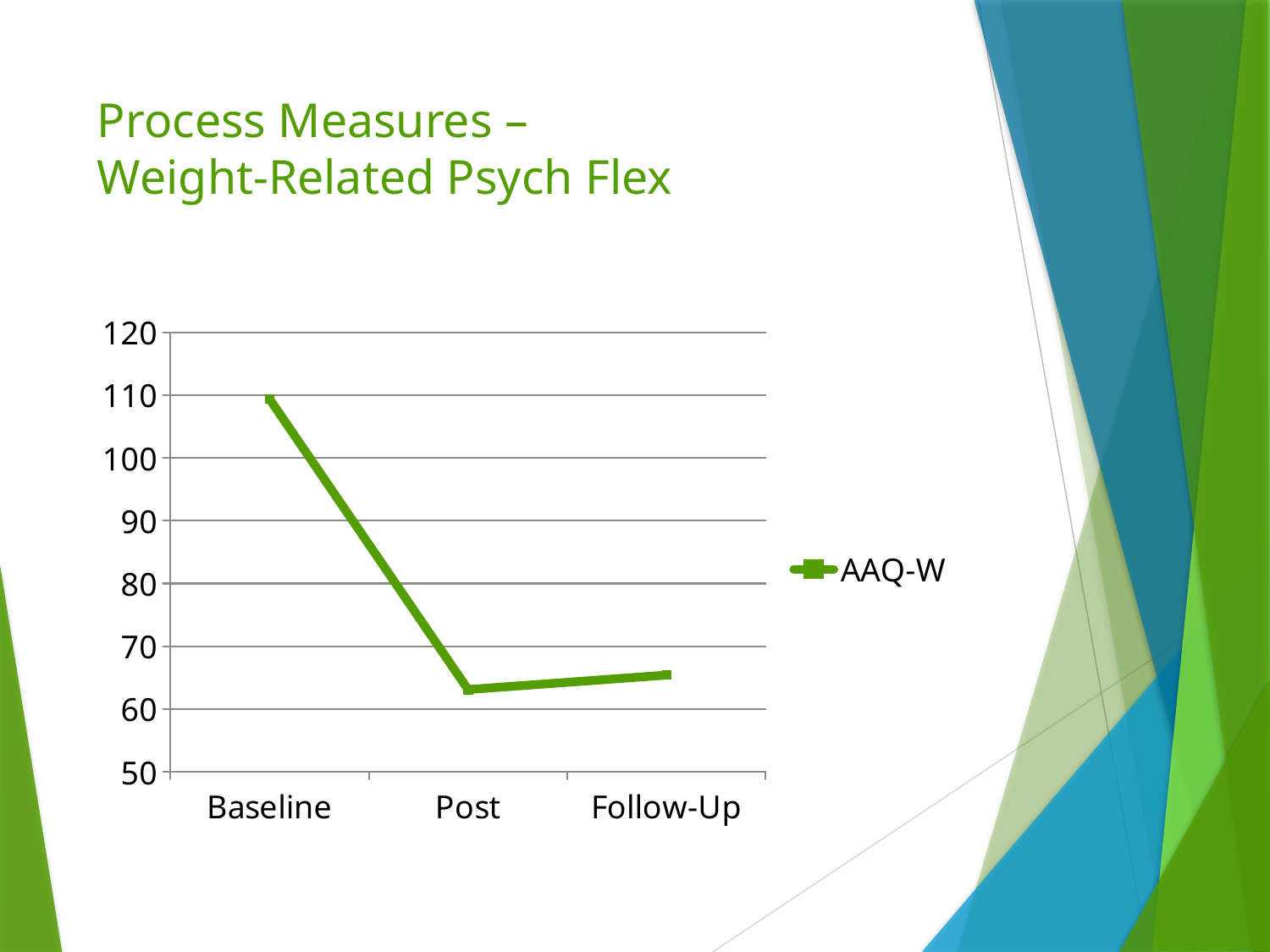
Is the AAQ-W value at Baseline greater or less than 100? greater Which has the larger AAQ-W value, Baseline or Post? Baseline What kind of chart is shown on the slide? line chart Is the AAQ-W value at Post greater or less than 60? greater How many series does the legend list? 1 Is the AAQ-W value at Post greater or less than 70? less Does the AAQ-W value rise or fall from Baseline to Post? fall At which time point is the AAQ-W value highest? Baseline What is the name of the series shown in the legend? AAQ-W How many time points are plotted on the x axis? 3 What is the title of the slide containing the chart? Process Measures – Weight-Related Psych Flex